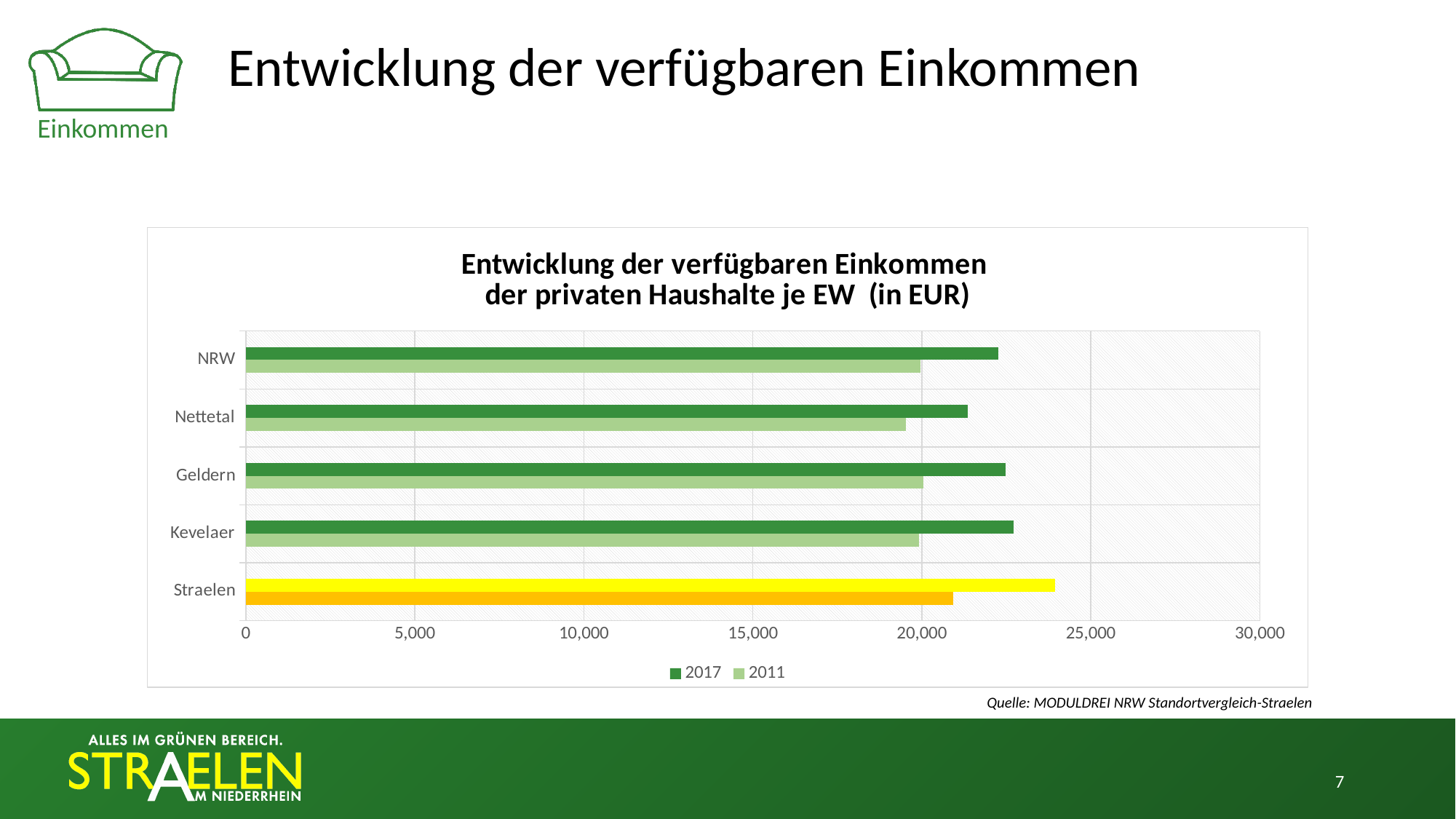
How many series does the legend list? 2 Which category has the lowest value for 2017? Nettetal Which category has the highest value for 2017? Straelen Which is larger, the 2017 value for Straelen or the 2017 value for Kevelaer? Straelen Which years are listed in the chart legend? 2017 and 2011 Is the 2017 value for Straelen greater or less than 20,000? greater What kind of chart is shown on the slide? bar chart Is the 2017 value for Geldern greater or less than 25,000? less Is the 2011 value for Nettetal greater or less than 20,000? less Which category has the highest value for 2011? Straelen Which is larger, the 2017 value for NRW or the 2017 value for Nettetal? NRW How many categories (regions) are shown on the chart? 5